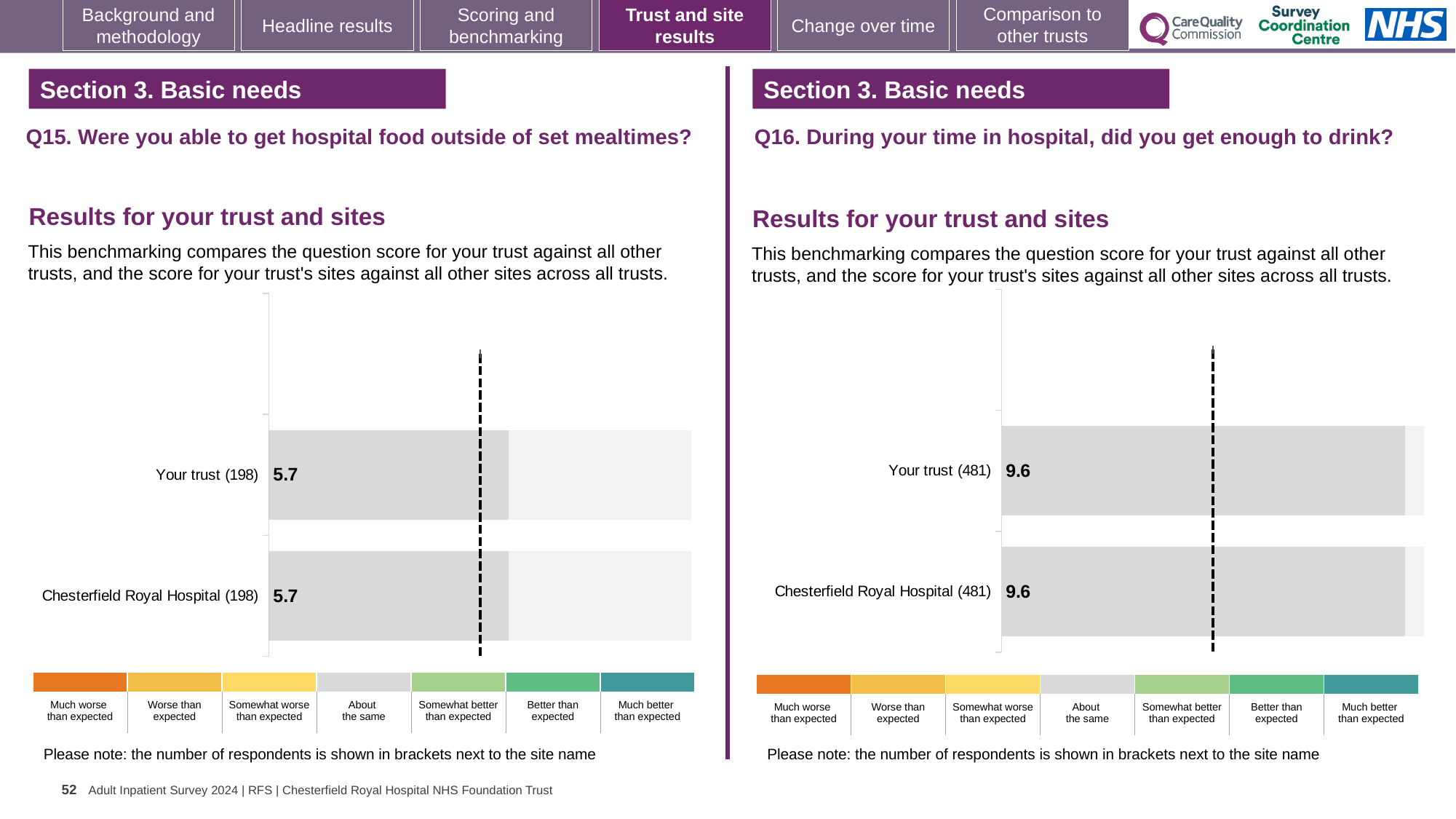
How many bars are plotted on the Q16 chart (right)? 2 On the Q16 chart (right), what is the score for Your trust? 9.6 How many bars are plotted on the Q15 chart (left)? 2 On the Q15 chart (left), what is the difference between the score for Your trust and the score for Chesterfield Royal Hospital? 0 On the Q15 chart (left), what is the score for Your trust? 5.7 On the Q16 chart (right), what is the difference between the score for Your trust and the score for Chesterfield Royal Hospital? 0 What is the question text shown above the left chart? Q15. Were you able to get hospital food outside of set mealtimes? On the Q15 chart (left), what is the score for Chesterfield Royal Hospital? 5.7 On the Q16 chart (right), how many respondents are shown in brackets next to Your trust? 481 On the Q15 chart (left), how many respondents are shown in brackets next to Chesterfield Royal Hospital? 198 On the Q16 chart (right), what is the score for Chesterfield Royal Hospital? 9.6 What kind of chart is used on the Q16 chart (right)? Bar chart